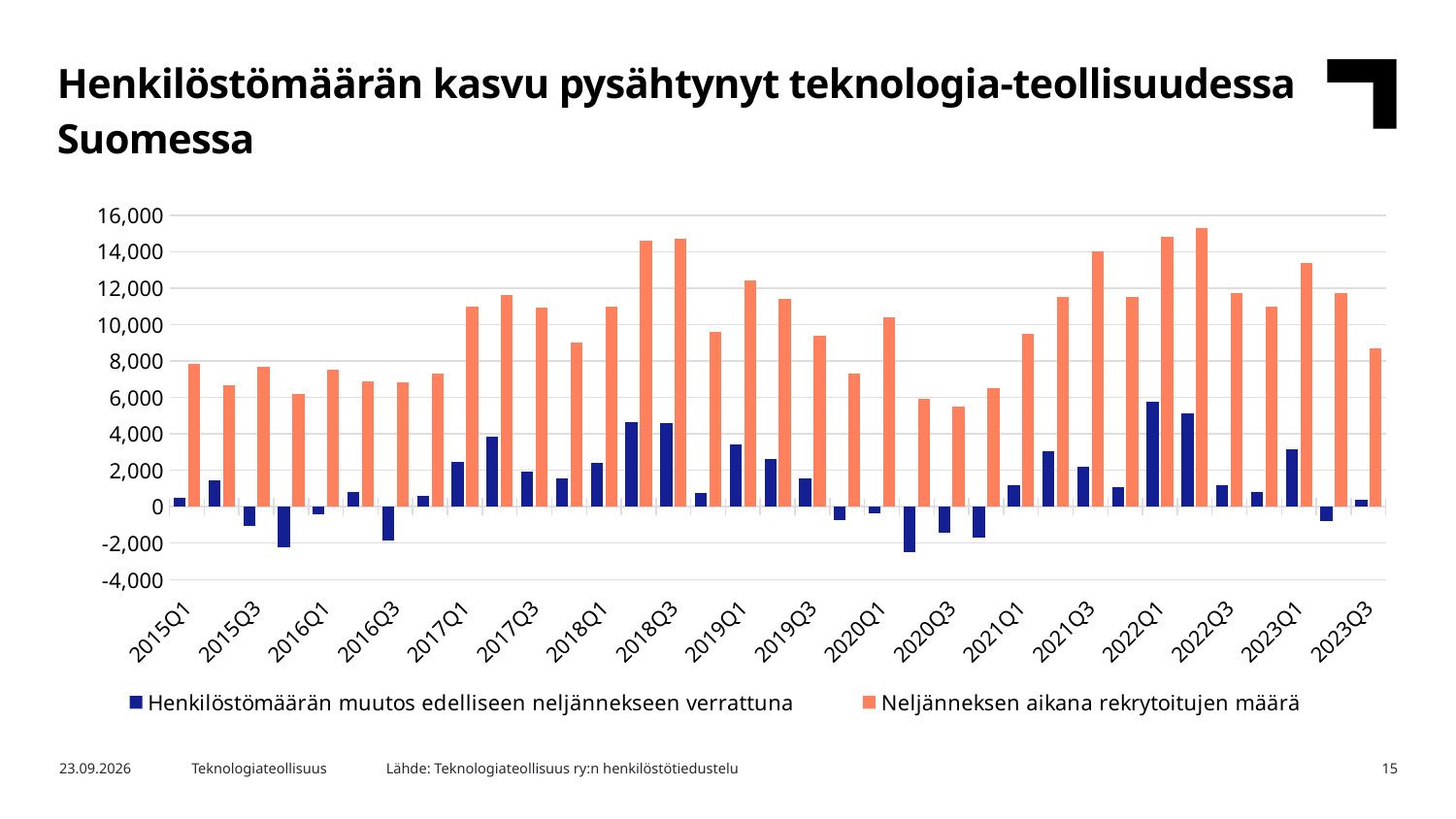
Is the value of Henkilöstömäärän muutos edelliseen neljännekseen verrattuna for 2022Q1 greater or less than 4,000? greater How many quarter labels are shown on the x axis? 18 Which is larger for Neljänneksen aikana rekrytoitujen määrä: 2017Q1 or 2015Q1? 2017Q1 Which series is drawn in orange? Neljänneksen aikana rekrytoitujen määrä What kind of chart is shown on the slide? Bar chart Is the value of Neljänneksen aikana rekrytoitujen määrä for 2020Q3 greater or less than 6,000? less Is the value of Henkilöstömäärän muutos edelliseen neljännekseen verrattuna for 2020Q2 greater or less than -2,000? less Which quarter has the highest value of Henkilöstömäärän muutos edelliseen neljännekseen verrattuna? 2022Q1 What is the title of the slide containing the chart? Henkilöstömäärän kasvu pysähtynyt teknologia-teollisuudessa Suomessa How many series does the legend list? 2